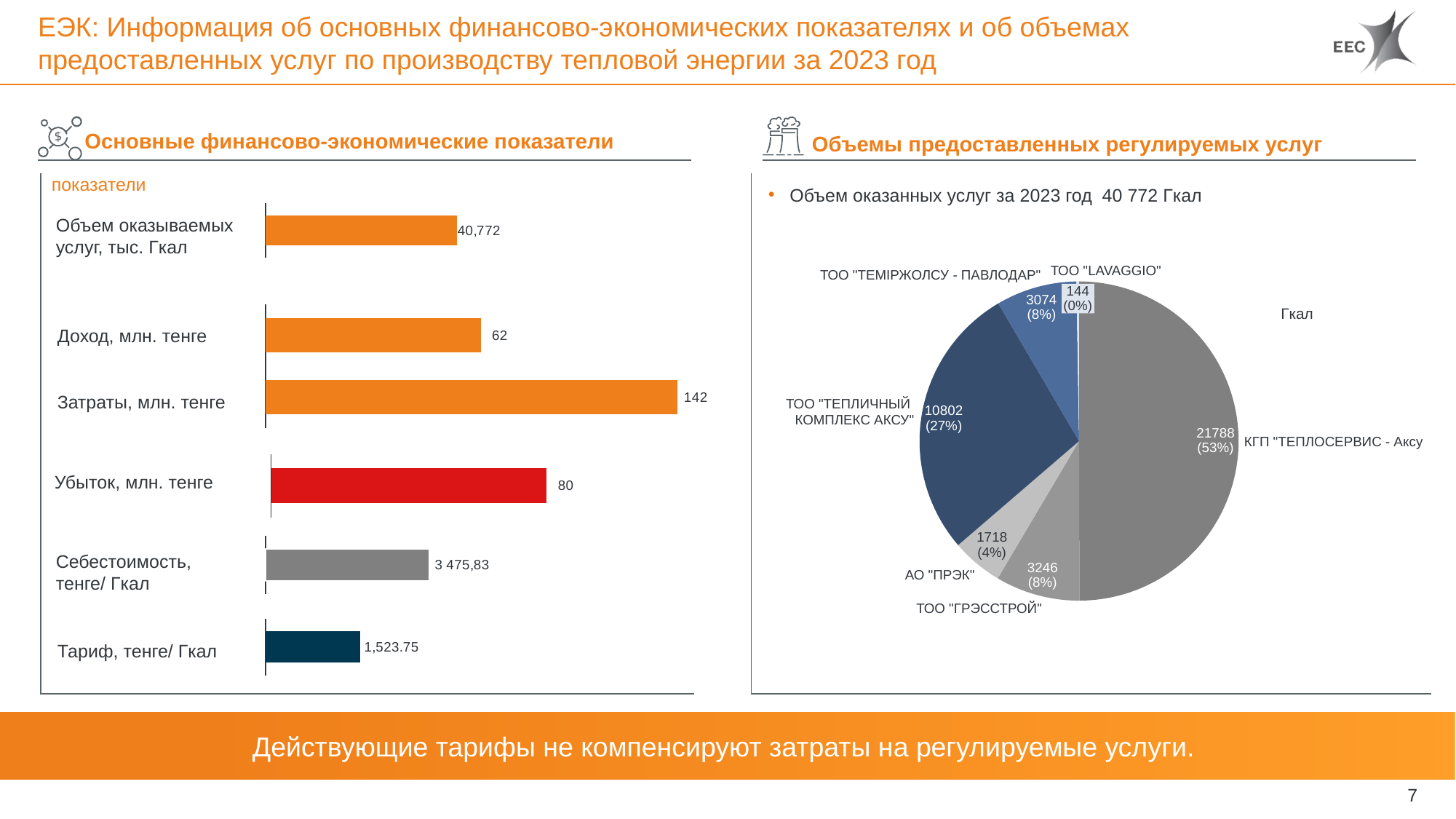
On the pie chart 'Объемы предоставленных регулируемых услуг', which company has the smallest slice? ТОО "LAVAGGIO" On the bar chart 'Основные финансово-экономические показатели', which is larger: 'Затраты, млн. тенге' or 'Доход, млн. тенге'? Затраты, млн. тенге How many categories are shown on the bar chart 'Основные финансово-экономические показатели'? 6 On the bar chart 'Основные финансово-экономические показатели', what is the difference between 'Затраты, млн. тенге' and 'Доход, млн. тенге'? 80 On the bar chart 'Основные финансово-экономические показатели', what is the value for 'Затраты, млн. тенге'? 142 On the bar chart 'Основные финансово-экономические показатели', what is the value for 'Доход, млн. тенге'? 62 On the pie chart 'Объемы предоставленных регулируемых услуг', what is the value for КГП "ТЕПЛОСЕРВИС - Аксу"? 21788 On the bar chart 'Основные финансово-экономические показатели', what is the value for 'Тариф, тенге/ Гкал'? 1,523.75 On the pie chart 'Объемы предоставленных регулируемых услуг', what share does ТОО "ТЕПЛИЧНЫЙ КОМПЛЕКС АКСУ" have? 27% What kind of chart is 'Объемы предоставленных регулируемых услуг'? Pie chart On the bar chart 'Основные финансово-экономические показатели', what is the value for 'Себестоимость, тенге/ Гкал'? 3 475,83 How many slices does the pie chart 'Объемы предоставленных регулируемых услуг' have? 6